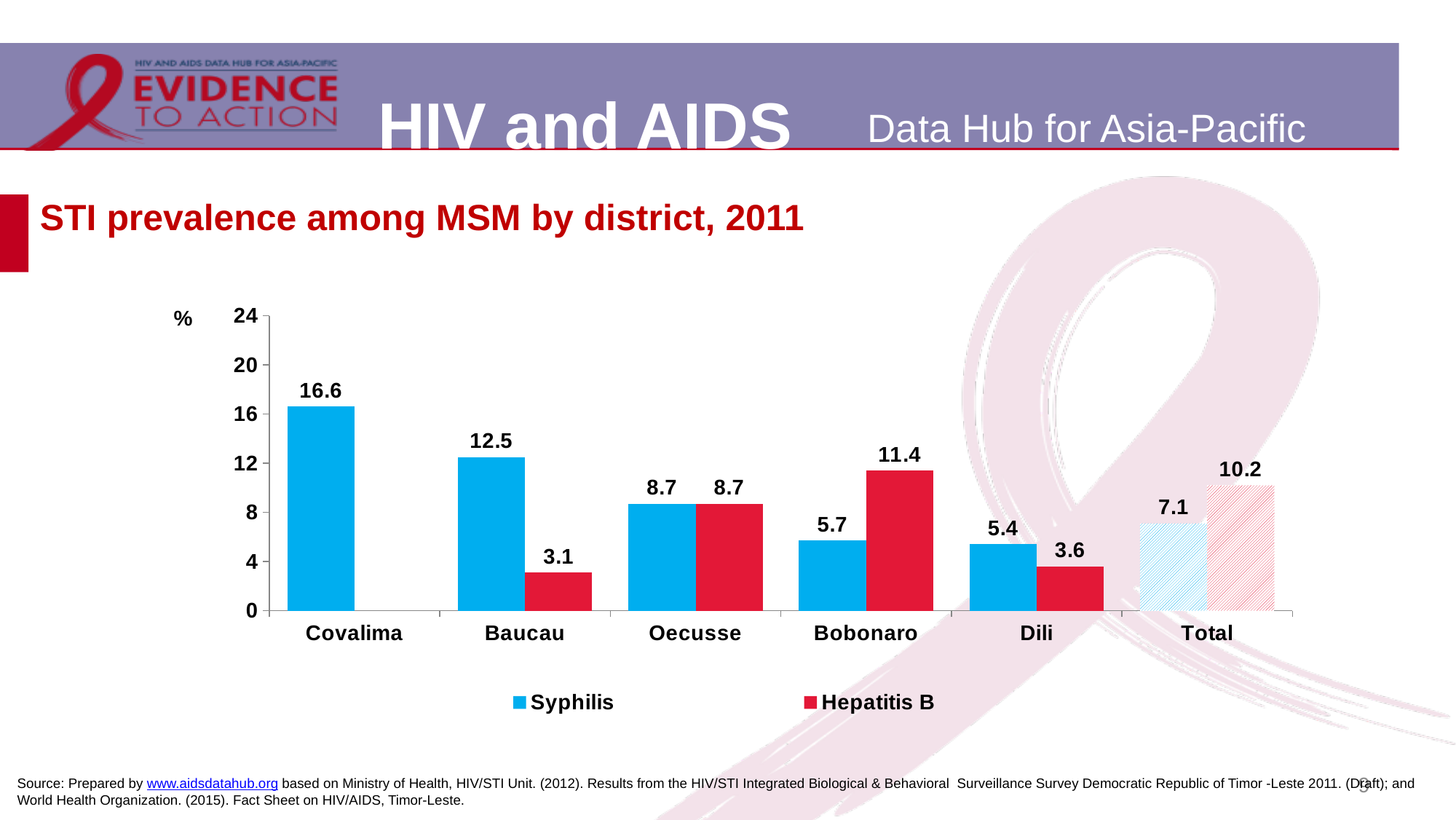
What is the Syphilis prevalence for Covalima? 16.6 How many series does the legend list? 2 Which category has the lowest Hepatitis B value? Baucau What kind of chart is shown on the slide? Bar chart What is the difference between the Syphilis and Hepatitis B values for Bobonaro? 5.7 Is the Syphilis value for Baucau greater or less than 8? greater What is the Hepatitis B prevalence for Bobonaro? 11.4 Which district has the highest Syphilis prevalence? Covalima Which is larger for Dili, the Syphilis value or the Hepatitis B value? Syphilis What is the Hepatitis B value for Baucau? 3.1 What is the Syphilis value for the Total category? 7.1 How many categories are shown on the x axis? 6